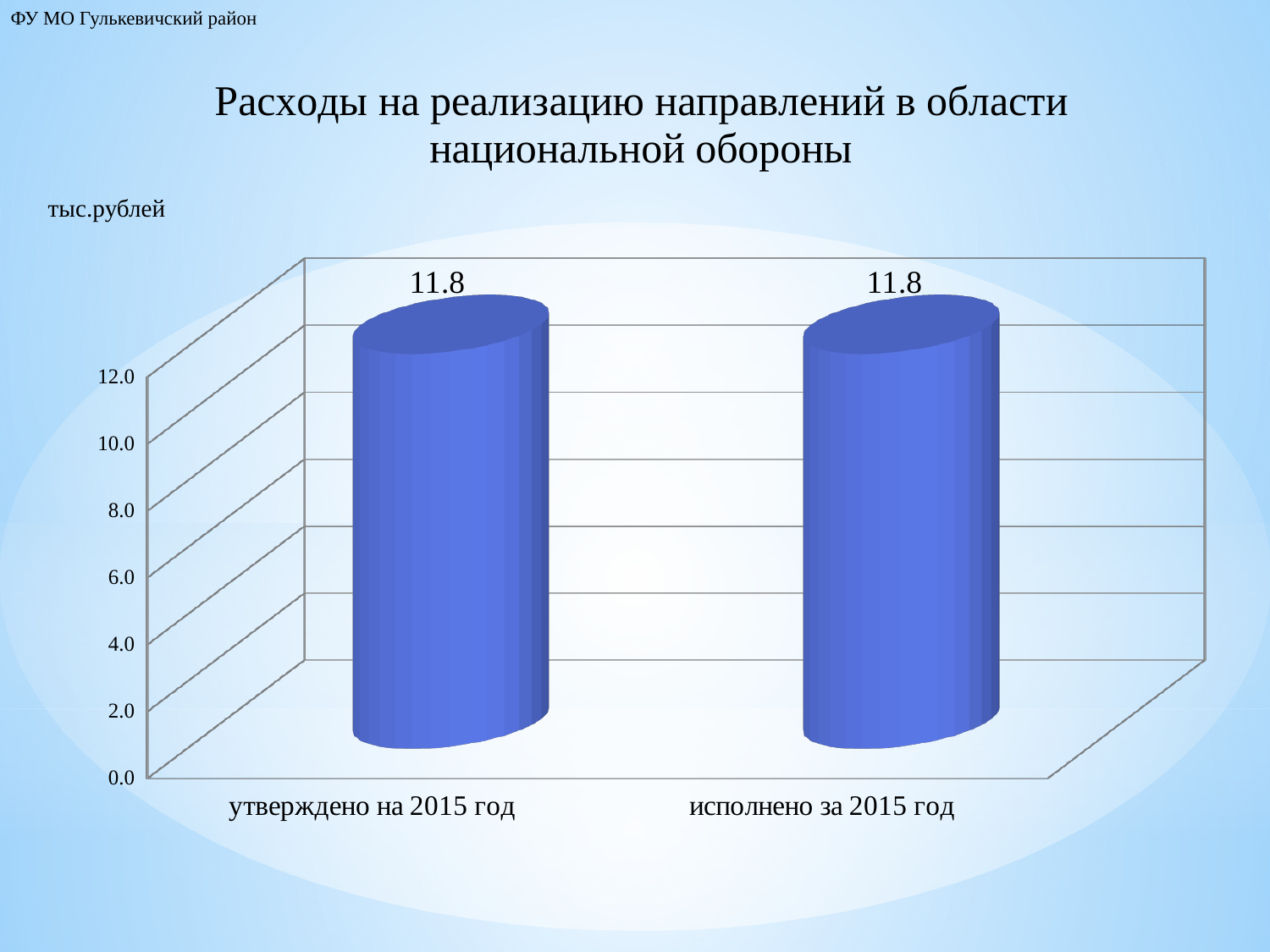
What kind of chart is shown on the slide? bar chart How many categories are shown on the x axis of the chart? 2 What is the title of the chart? Расходы на реализацию направлений в области национальной обороны Do the values rise, fall or stay the same from "утверждено на 2015 год" to "исполнено за 2015 год"? stay the same What is the value for "утверждено на 2015 год"? 11.8 What is the highest tick value shown on the vertical axis? 12.0 Is the value for "утверждено на 2015 год" greater or less than 10.0? greater Is the value for "исполнено за 2015 год" greater or less than 12.0? less What is the value for "исполнено за 2015 год"? 11.8 In what units are the values on the chart expressed? тыс.рублей What is the difference between the value for "утверждено на 2015 год" and the value for "исполнено за 2015 год"? 0.0